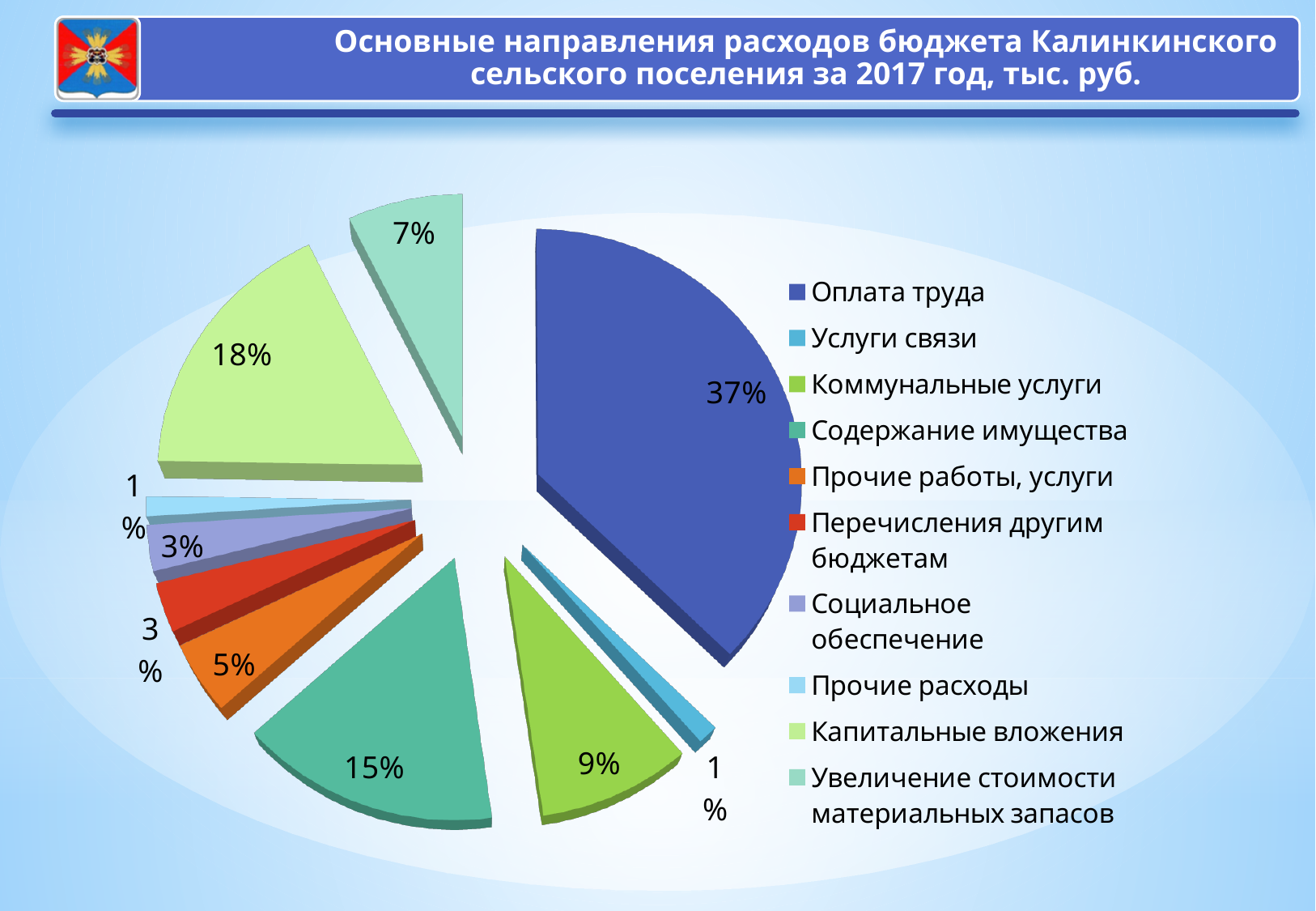
What percentage is shown for Капитальные вложения? 18% What colour is the slice for Оплата труда? blue What percentage is shown for Прочие работы, услуги? 5% How many categories does the legend list? 10 What percentage is shown for Коммунальные услуги? 9% What share of the budget expenditure is labelled for Оплата труда? 37% What percentage is shown for Содержание имущества? 15% Which is larger, the share for Содержание имущества or the share for Коммунальные услуги? Содержание имущества What type of chart is shown on the slide? pie chart Which category has the largest share of the pie? Оплата труда What percentage is shown for Увеличение стоимости материальных запасов? 7% What is the difference in percentage points between Оплата труда and Капитальные вложения? 19